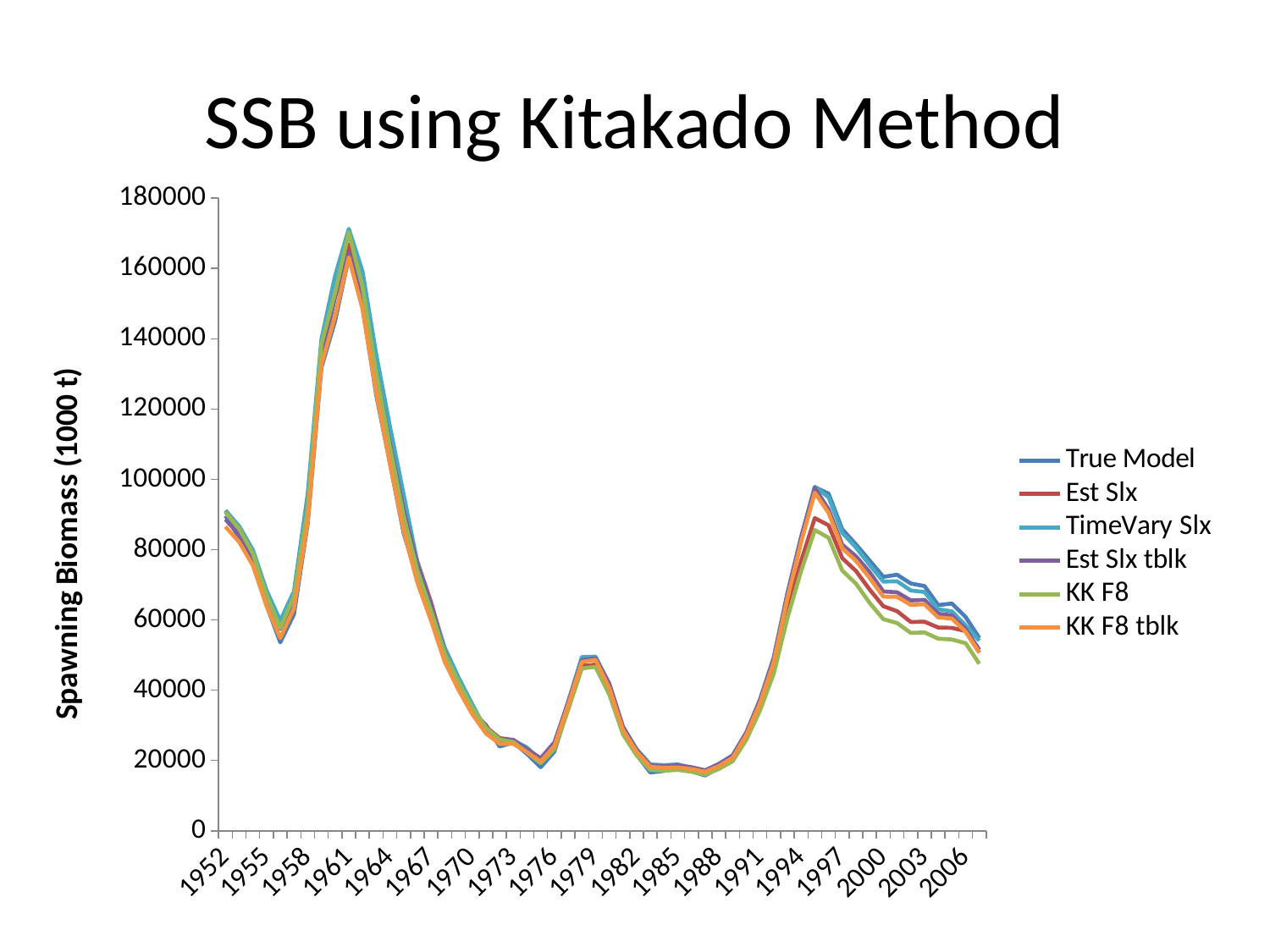
What is the highest value shown on the y axis? 180000 Which series are listed in the legend? True Model, Est Slx, TimeVary Slx, Est Slx tblk, KK F8, KK F8 tblk Is the peak value of the True Model series around 1961-1964 greater or less than 140000? greater Is the value of the True Model series in 1952 greater or less than 80000? greater What kind of chart is shown on the slide? line chart In 2006, which series has the higher value, True Model or KK F8? True Model Do the values rise or fall between 1964 and 1973? fall Is the value of the KK F8 series in 1979 greater or less than 60000? less Do the values rise or fall between 1988 and 1994? rise How many series does the legend list? 6 What is the title of the chart? SSB using Kitakado Method